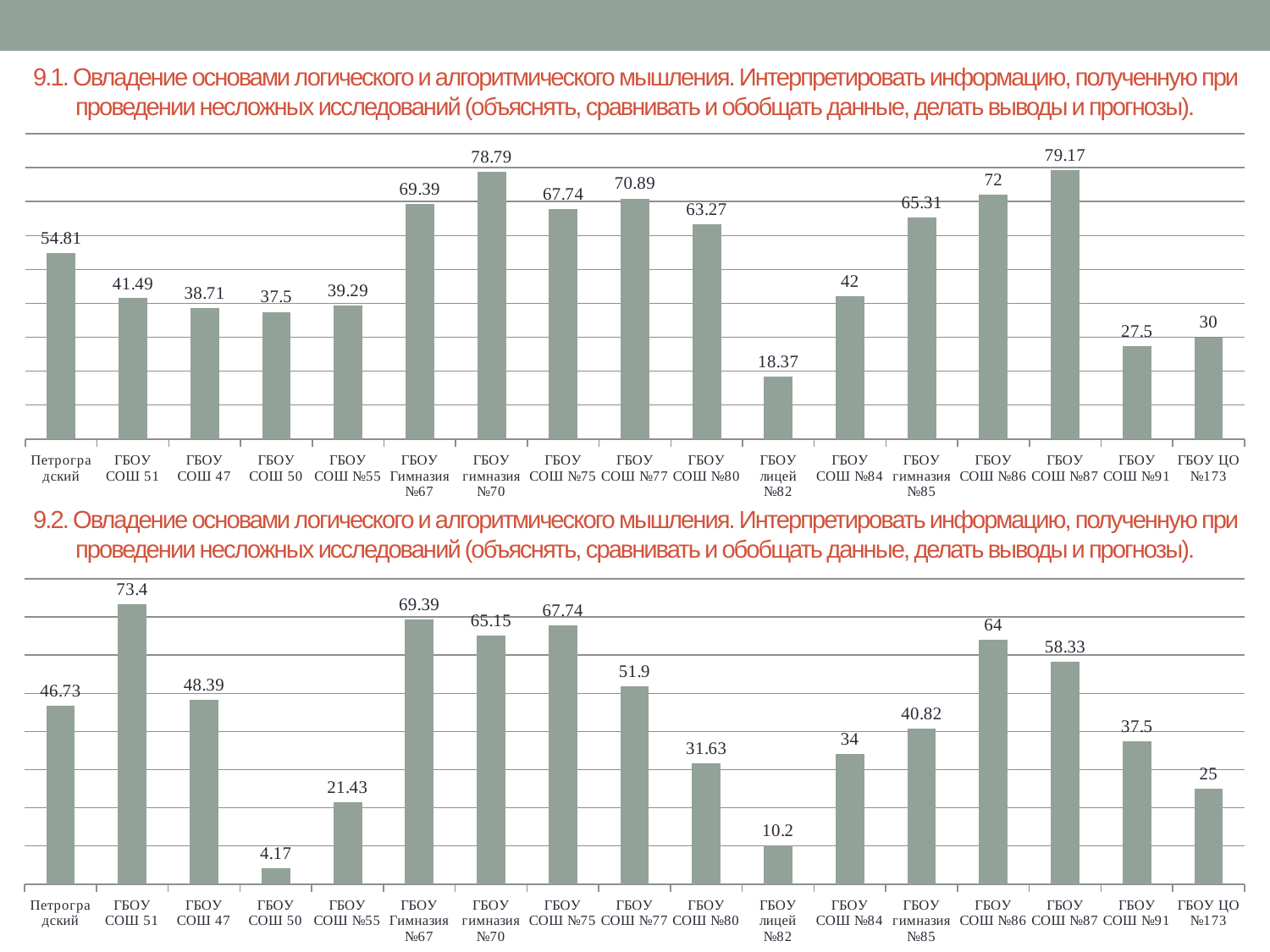
In the bottom chart (9.2), what is the value for ГБОУ СОШ 50? 4.17 In the top chart (9.1), what is the difference between the values for ГБОУ СОШ №86 and ГБОУ СОШ №84? 30 In the bottom chart (9.2), what is the difference between the values for ГБОУ СОШ №91 and ГБОУ ЦО №173? 12.5 In the top chart (9.1), which category has the lowest value? ГБОУ лицей №82 In the top chart (9.1), which is larger: the value for ГБОУ СОШ №77 or ГБОУ СОШ №80? ГБОУ СОШ №77 In the top chart (9.1), what is the value for ГБОУ гимназия №70? 78.79 In the bottom chart (9.2), which is larger: the value for Петроградский or ГБОУ СОШ 47? ГБОУ СОШ 47 What type of chart is the top chart (9.1)? Bar chart In the bottom chart (9.2), which category has the highest value? ГБОУ СОШ 51 In the bottom chart (9.2), which category has the lowest value? ГБОУ СОШ 50 How many categories are shown in the bottom chart (9.2)? 17 In the top chart (9.1), which category has the highest value? ГБОУ СОШ №87